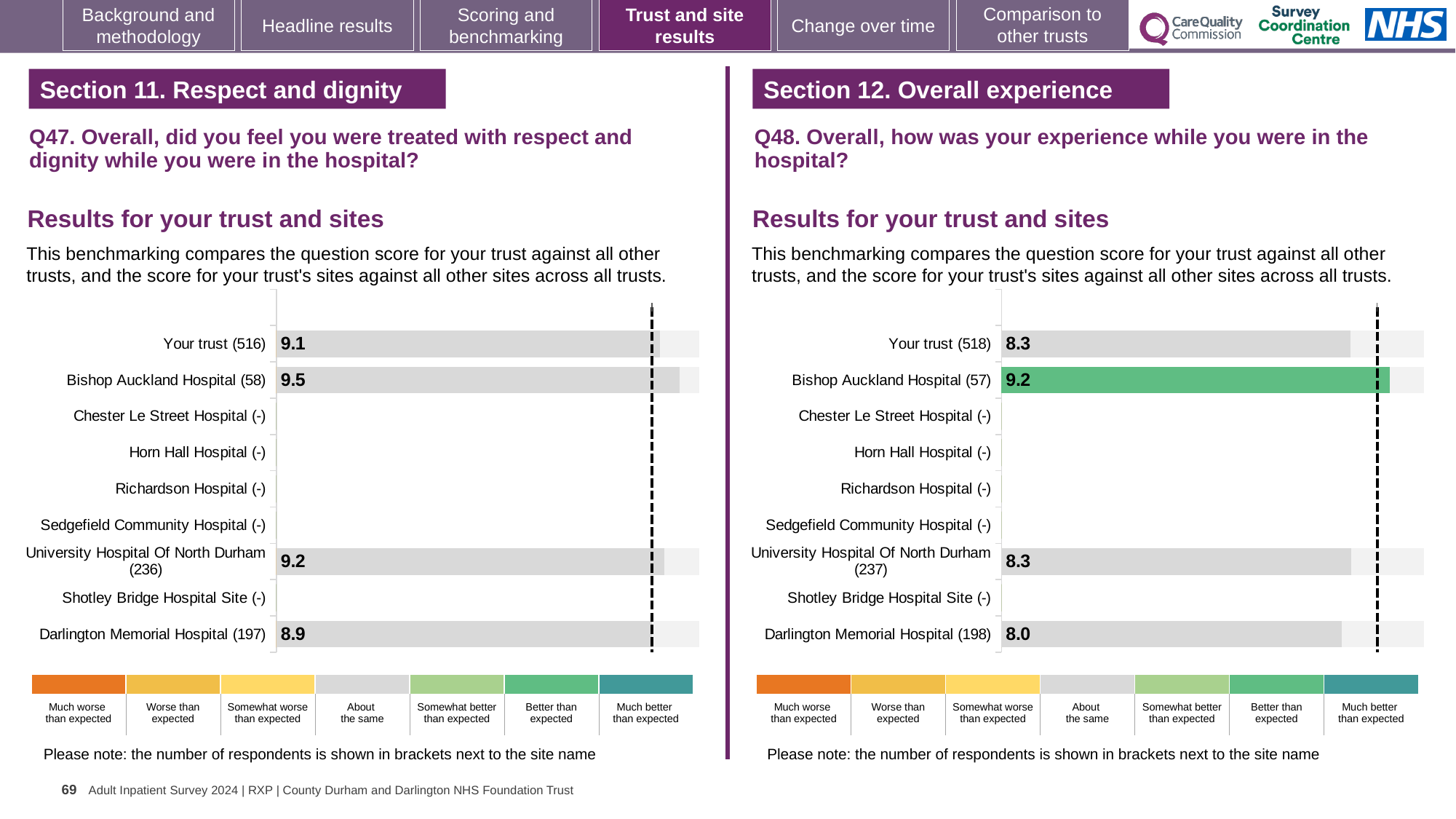
In the Q47 chart on the left, what is the score for Your trust (516)? 9.1 In the Q47 chart on the left, which has the higher score: University Hospital Of North Durham or Your trust? University Hospital Of North Durham In the Q48 chart on the right, what is the score for University Hospital Of North Durham (237)? 8.3 What type of chart is used in the Q47 chart on the left? Bar chart In the Q48 chart on the right, how many rows have a score bar plotted? 4 In the Q47 chart on the left, what is the score for Bishop Auckland Hospital (58)? 9.5 In the Q48 chart on the right, which site has the highest score? Bishop Auckland Hospital (57) In the Q48 chart on the right, what is the difference between the scores for Bishop Auckland Hospital and Your trust? 0.9 In the Q48 chart on the right, which site's bar is coloured green? Bishop Auckland Hospital (57) In the Q48 chart on the right, what is the score for Darlington Memorial Hospital (198)? 8.0 In the Q47 chart on the left, which site has the lowest score? Darlington Memorial Hospital (197) In the Q47 chart on the left, what is the difference between the scores for Bishop Auckland Hospital and Darlington Memorial Hospital? 0.6